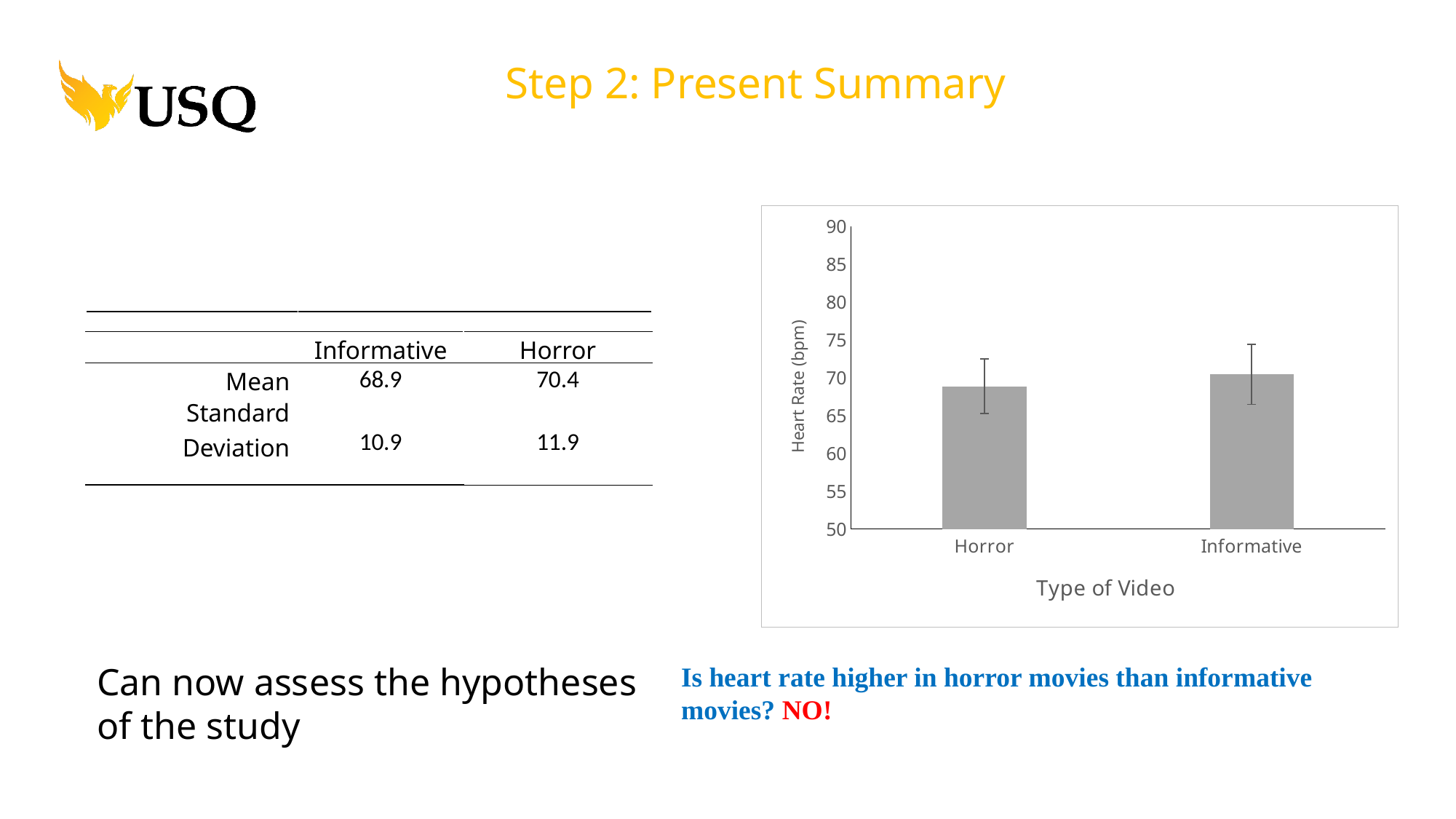
Which category has the highest bar in the chart? Informative Is the value for Horror greater or less than 75? less What kind of chart is shown on the slide? bar chart What is the label of the x axis of the chart? Type of Video Is the value for Horror greater or less than 65? greater Which type of video has the taller bar in the chart, Horror or Informative? Informative Is the value for Informative greater or less than 65? greater What is the label of the y axis of the chart? Heart Rate (bpm) How many categories are plotted on the x axis of the chart? 2 Which category has the lowest bar in the chart? Horror